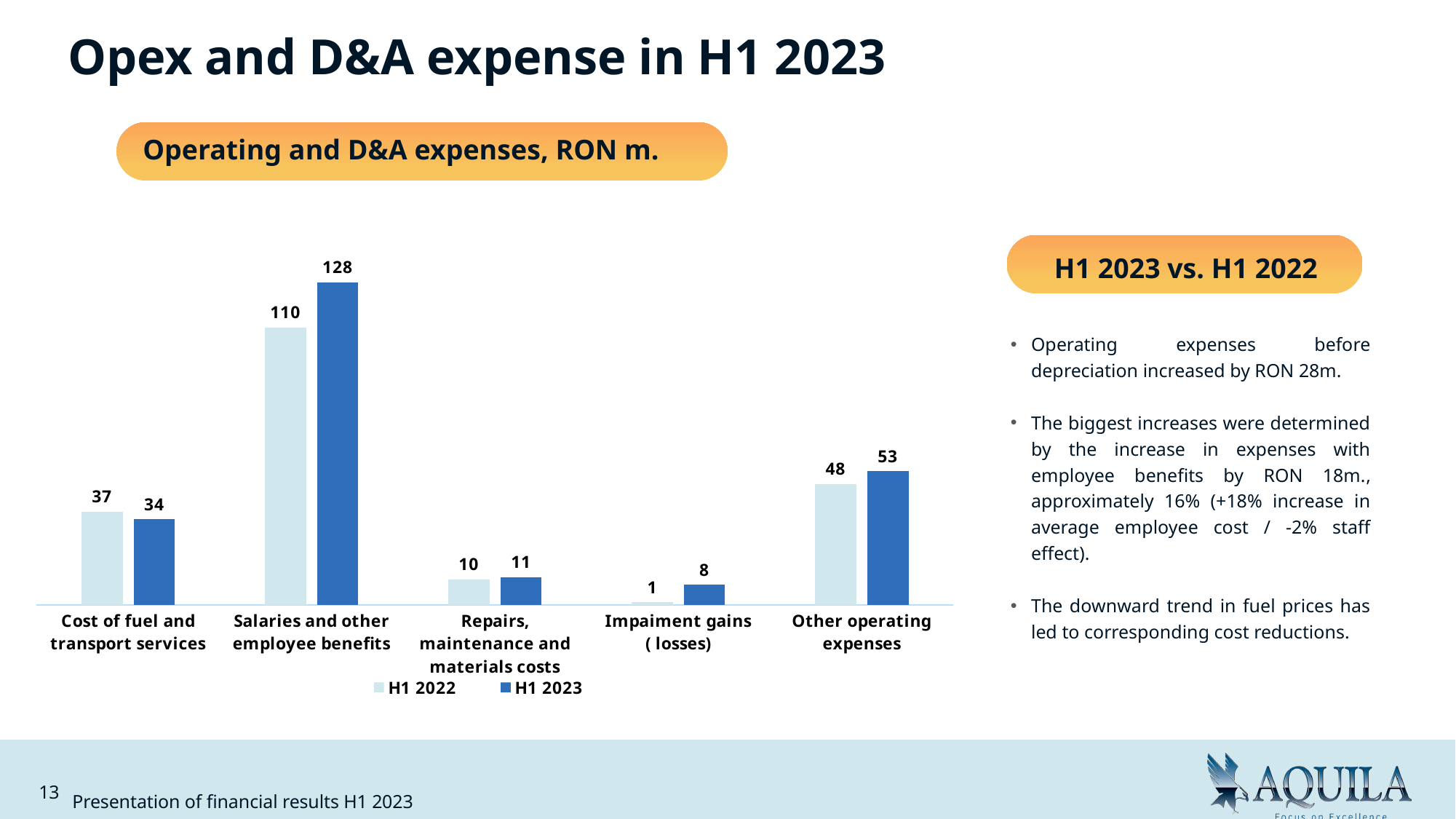
What is the H1 2023 value for Impaiment gains (losses)? 8 What kind of chart is shown on the slide? Bar chart Which category has the lowest H1 2022 value? Impaiment gains (losses) What is the H1 2023 value for Salaries and other employee benefits? 128 How many series does the legend list? 2 What unit is stated in the chart's title? RON m. Which category has the highest H1 2023 value? Salaries and other employee benefits What is the H1 2022 value for Cost of fuel and transport services? 37 For Other operating expenses, which is larger: the H1 2022 value or the H1 2023 value? H1 2023 What is the difference between the H1 2023 and H1 2022 values for Salaries and other employee benefits? 18 How many categories are shown on the x axis of the chart? 5 What is the difference between the H1 2022 and H1 2023 values for Cost of fuel and transport services? 3